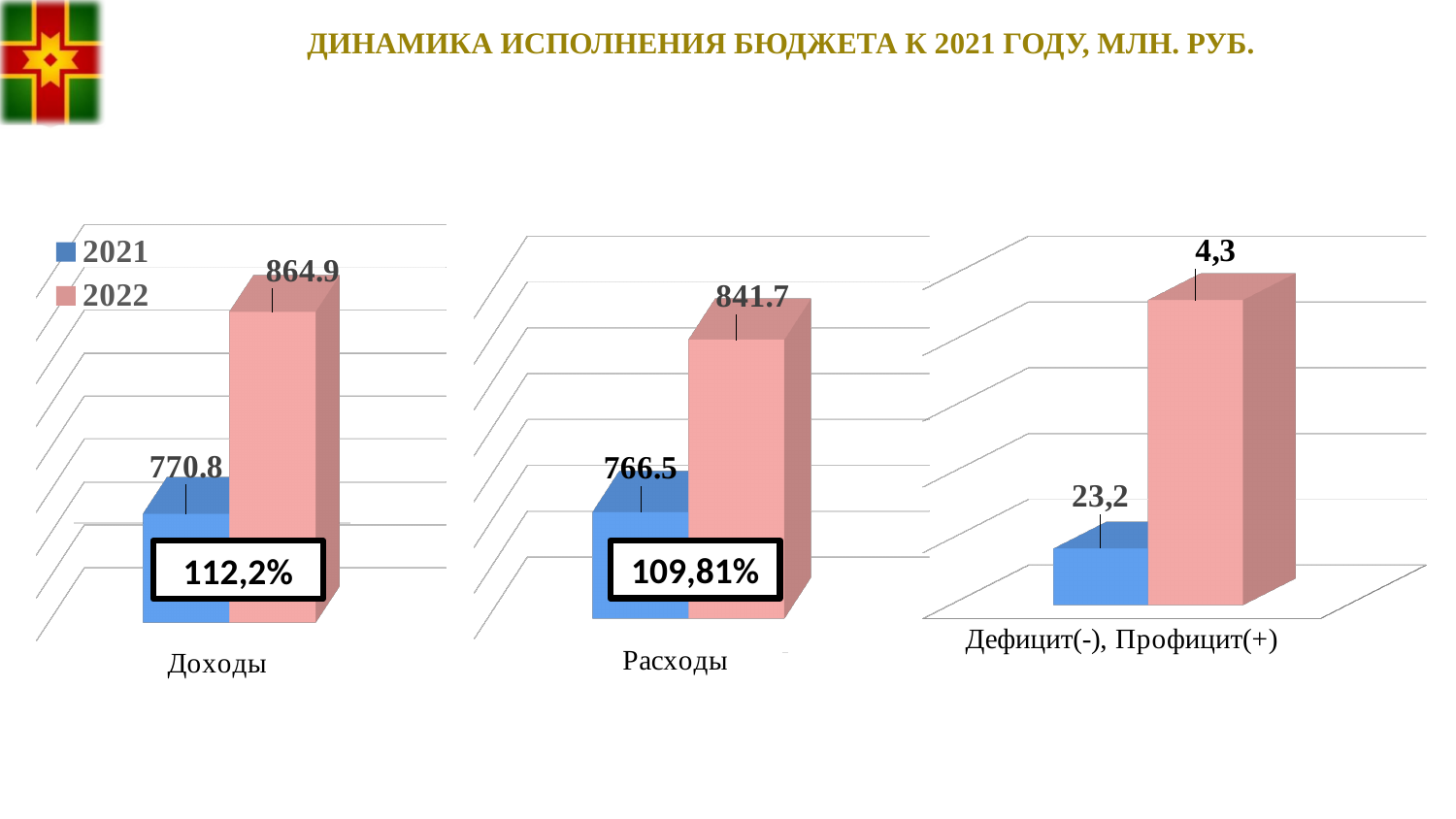
In the Доходы chart, what is the difference between the 2022 and 2021 values? 94.1 How many series does the legend on the Доходы chart list? 2 In the Расходы chart, what is the difference between the 2022 and 2021 values? 75.2 In the Расходы chart, which year has the lower value? 2021 In the Доходы chart, what is the value for 2021? 770.8 In the Доходы chart, which year has the higher value, 2021 or 2022? 2022 What percentage is shown in the box on the Расходы chart? 109,81% In the Доходы chart, what is the value for 2022? 864.9 In the Дефицит(-), Профицит(+) chart, what value is labelled on the pink (2022) bar? 4,3 In the Расходы chart, what is the value for 2022? 841.7 In the Расходы chart, what is the value for 2021? 766.5 In the Дефицит(-), Профицит(+) chart, what value is labelled on the blue (2021) bar? 23,2